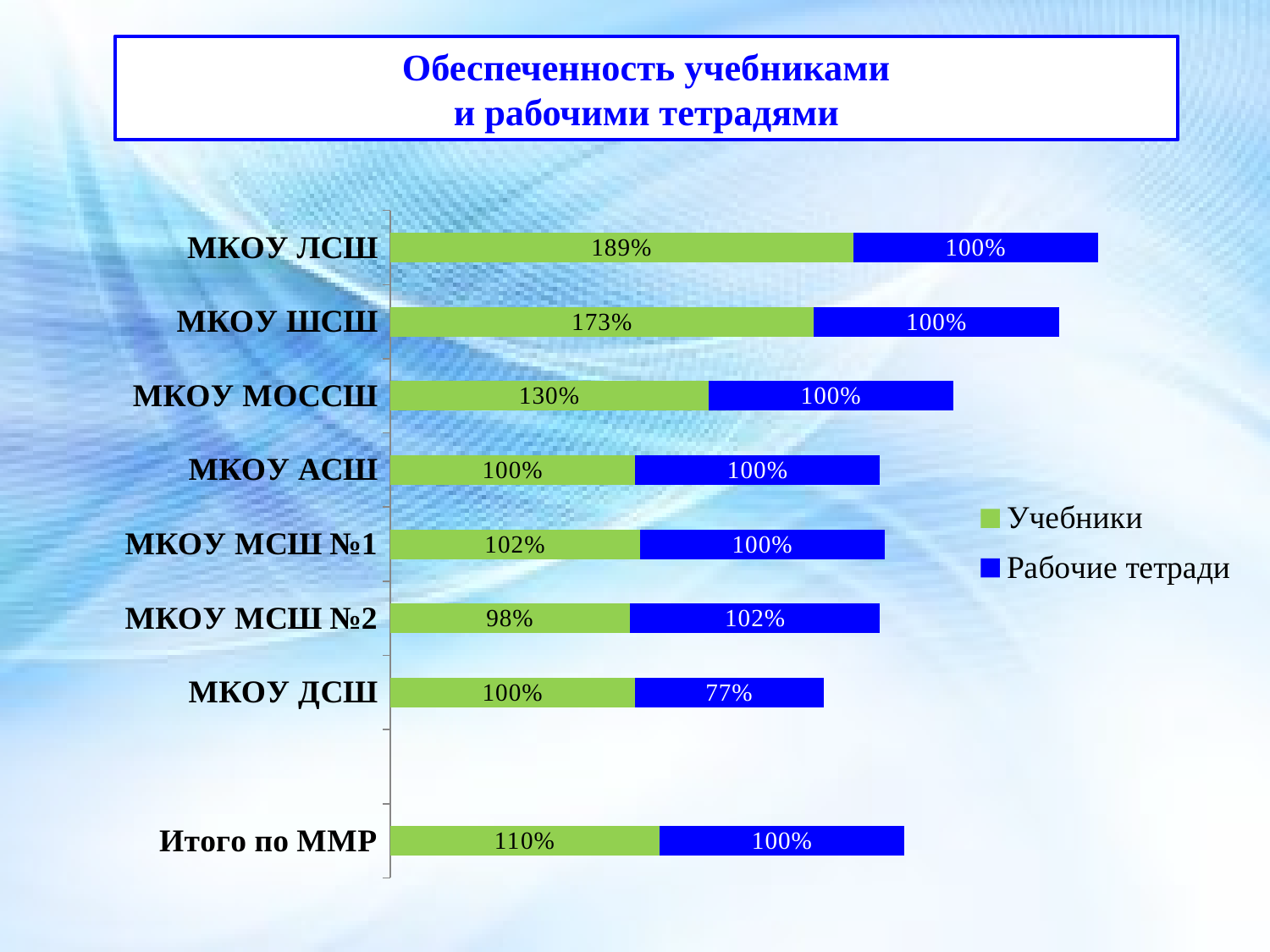
What is the total of the stacked bar for МКОУ ЛСШ? 289% How many series does the legend list? 2 What is the value for Рабочие тетради for МКОУ ДСШ? 77% Which category has the lowest value for Учебники? МКОУ МСШ №2 What is the value for Учебники for Итого по ММР? 110% Which category has the highest value for Учебники? МКОУ ЛСШ Which is larger: the Учебники value for МКОУ МОССШ or for МКОУ АСШ? МКОУ МОССШ Which category has the lowest value for Рабочие тетради? МКОУ ДСШ What is the value for Учебники for МКОУ ЛСШ? 189% What is the difference between the Учебники values for МКОУ ЛСШ and МКОУ ШСШ? 16% Which category has the highest value for Рабочие тетради? МКОУ МСШ №2 What kind of chart is shown on the slide? Stacked bar chart